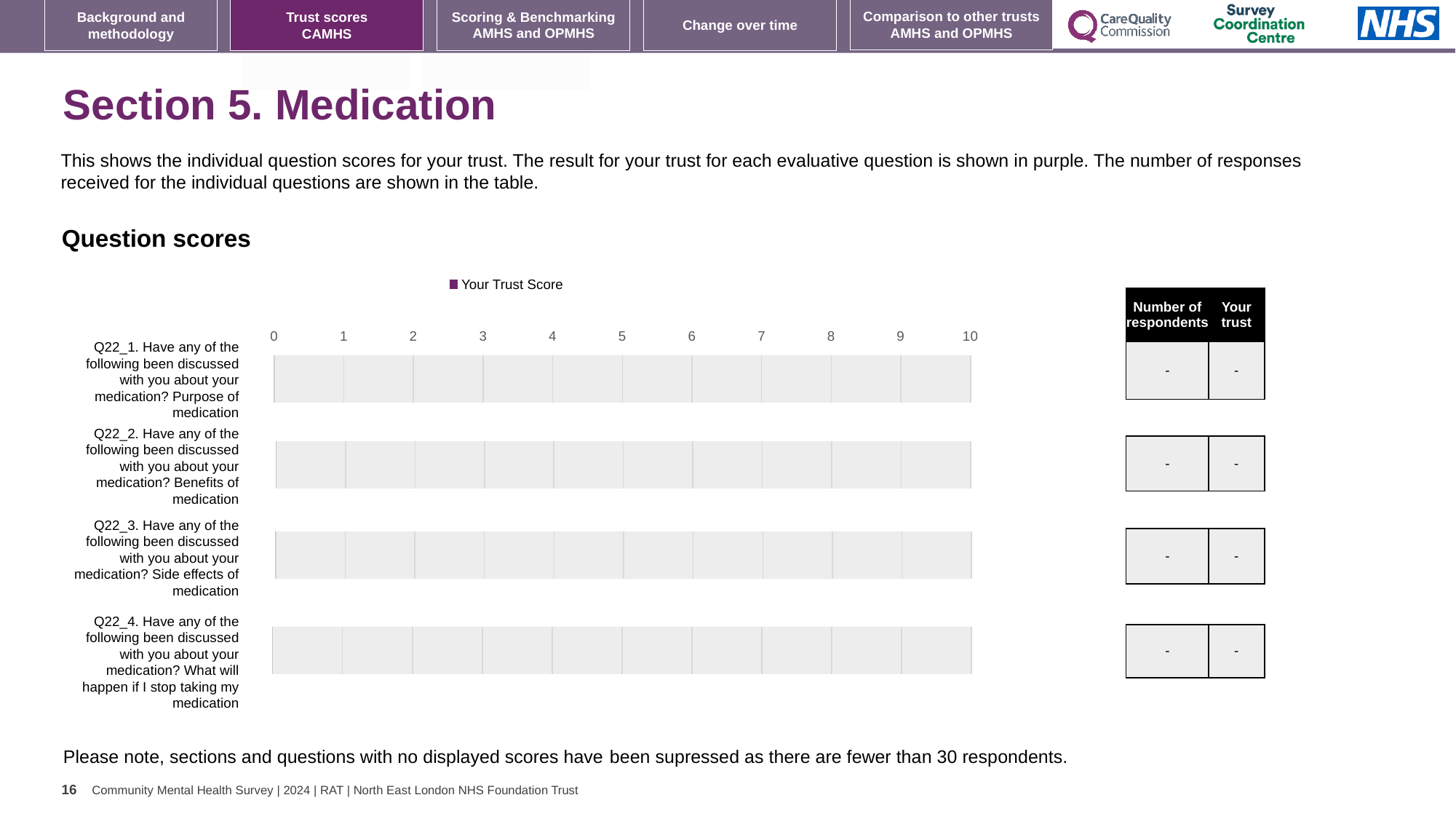
Are any bar values plotted for the four questions in the chart? No What is the name of the series shown in the chart legend? Your Trust Score How many series does the chart legend list? 1 How many question categories are listed on the y axis of the chart? 4 What value is shown in the "Number of respondents" column of the table for Q22_4? - What kind of chart is shown under the heading "Question scores"? bar chart What is the lowest value shown on the chart's x axis? 0 What is the highest value shown on the chart's x axis? 10 What value is shown in the "Your trust" column of the table for Q22_1? -